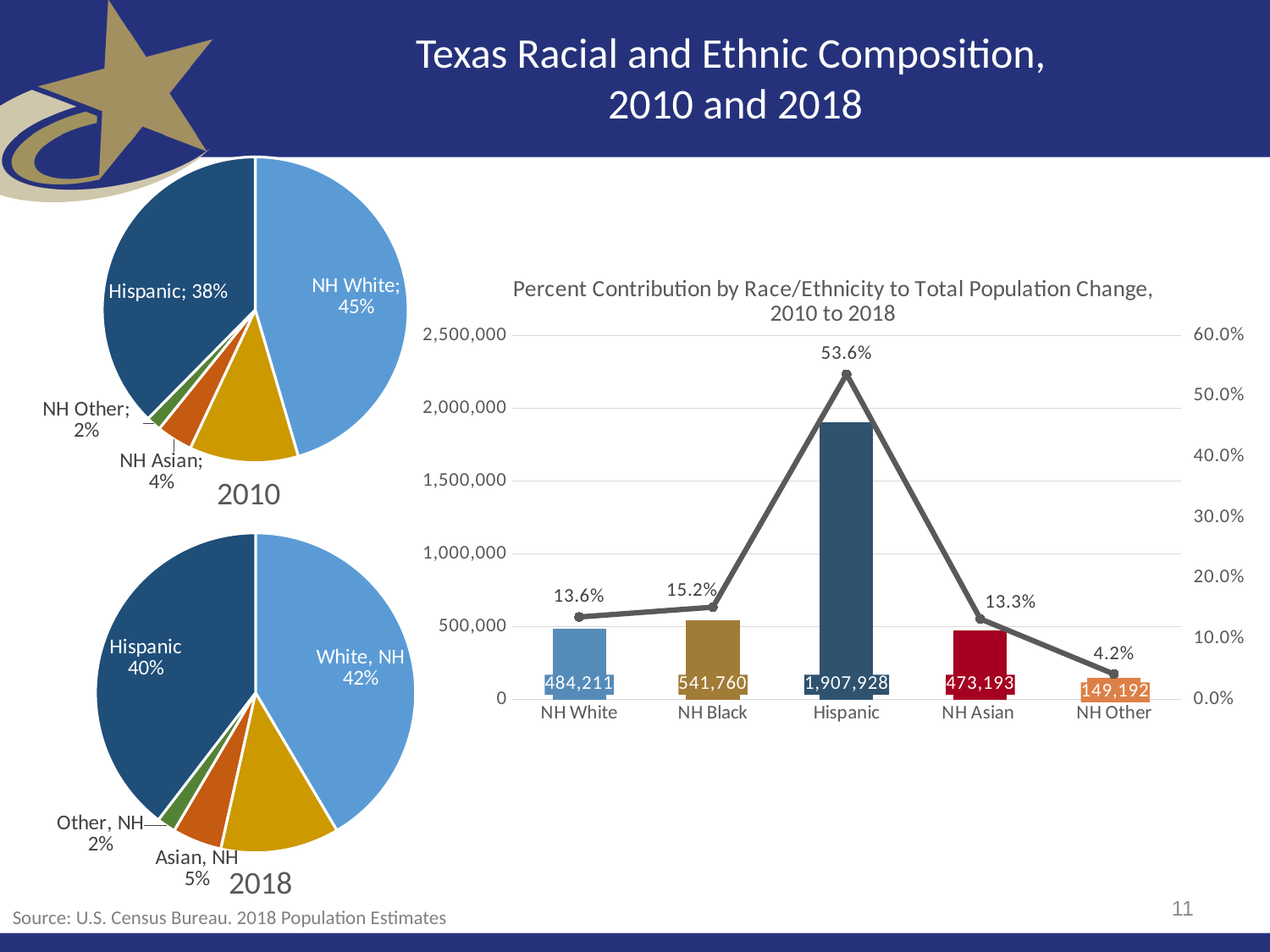
In the 2010 pie chart, which labelled slice is the largest? NH White In the 2018 pie chart, what share of the population is Asian, NH? 5% In the 2018 pie chart, what is the difference between the White, NH share and the Hispanic share? 2% In the 2010 pie chart, what share of the population is NH White? 45% In the 'Percent Contribution by Race/Ethnicity to Total Population Change, 2010 to 2018' chart, which bar is larger, NH White or NH Black? NH Black In the 'Percent Contribution by Race/Ethnicity to Total Population Change, 2010 to 2018' chart, what percent contribution is shown for NH Black? 15.2% In the 2018 pie chart, what share of the population is Hispanic? 40% In the 2010 pie chart, which labelled slice is the smallest? NH Other In the 'Percent Contribution by Race/Ethnicity to Total Population Change, 2010 to 2018' chart, how many categories are shown on the x axis? 5 In the 'Percent Contribution by Race/Ethnicity to Total Population Change, 2010 to 2018' chart, which category has the highest bar? Hispanic In the 'Percent Contribution by Race/Ethnicity to Total Population Change, 2010 to 2018' chart, what is the bar value for NH Other? 149,192 In the 'Percent Contribution by Race/Ethnicity to Total Population Change, 2010 to 2018' chart, what is the bar value for Hispanic? 1,907,928